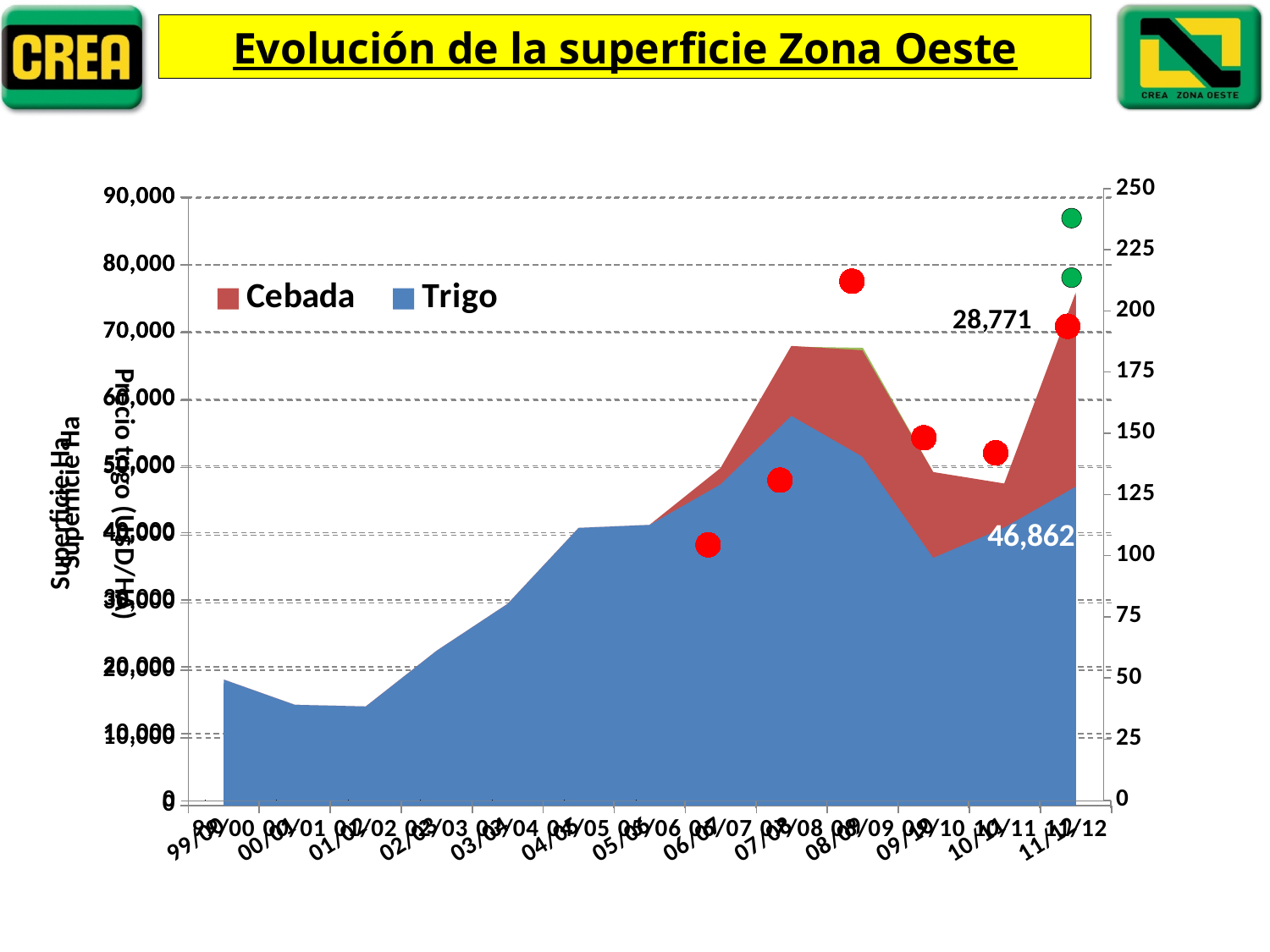
In which season is the Trigo value highest? 07/08 What is the title of the slide? Evolución de la superficie Zona Oeste How many series does the legend list? 2 What kind of chart is used to show the Cebada and Trigo surface? Area chart What is the Cebada value for 11/12? 28,771 How many seasons (categories) are shown on the x axis? 13 What is the total of the stacked area (Trigo plus Cebada) for 11/12? 75,633 Which is larger for 11/12, the Trigo value or the Cebada value? Trigo What is the Trigo value for 11/12? 46,862 Does the Trigo area rise or fall from 99/00 to 04/05? Rise Is the Trigo value for 01/02 greater or less than 20,000? less Is the Trigo value for 07/08 greater or less than 50,000? greater